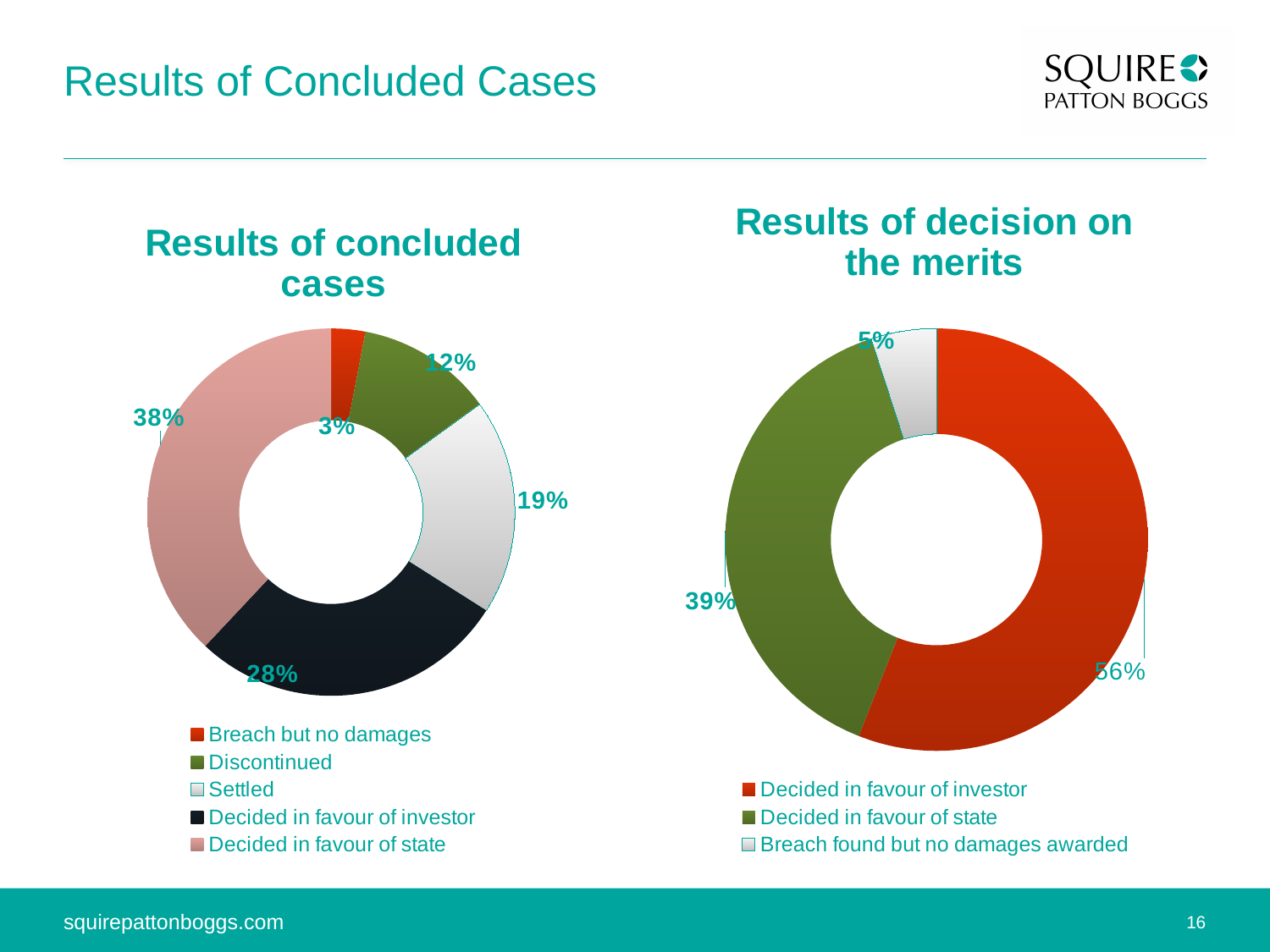
In the 'Results of concluded cases' chart, which category has the smallest share? Breach but no damages In the 'Results of decision on the merits' chart, which is larger: decided in favour of investor or decided in favour of state? Decided in favour of investor In the 'Results of decision on the merits' chart, what share of decisions were in favour of investor? 56% In the 'Results of concluded cases' chart, what is the difference between the share decided in favour of state and the share decided in favour of investor? 10% In the 'Results of decision on the merits' chart, what share of decisions found a breach but awarded no damages? 5% In the 'Results of concluded cases' chart, what share of cases were settled? 19% What kind of chart is the 'Results of decision on the merits' chart? Doughnut chart In the 'Results of decision on the merits' chart, what is the difference between the share decided in favour of investor and the share decided in favour of state? 17% In the 'Results of concluded cases' chart, which category has the largest share? Decided in favour of state How many categories does the legend of the 'Results of concluded cases' chart list? 5 In the 'Results of concluded cases' chart, what share of cases were decided in favour of state? 38% In the 'Results of concluded cases' chart, what share of cases were discontinued? 12%